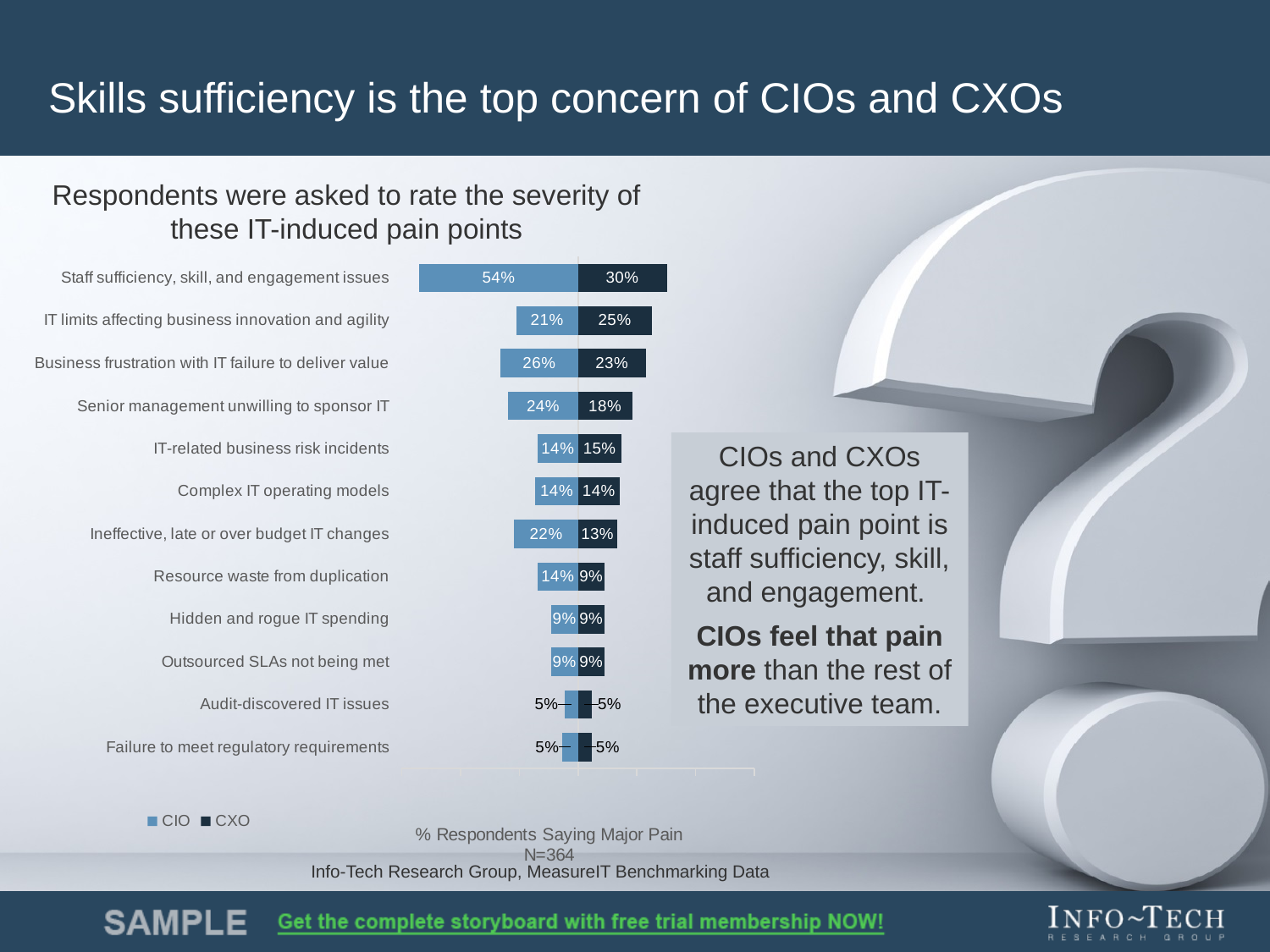
What is the CXO value for senior management unwilling to sponsor IT? 18% What percentage of CIO respondents said staff sufficiency, skill, and engagement issues were a major pain? 54% Which pain point has the highest CXO value? Staff sufficiency, skill, and engagement issues How many series does the legend list? 2 How many pain point categories are shown in the chart? 12 For business frustration with IT failure to deliver value, which is larger, the CIO value or the CXO value? CIO Which pain point has the highest CIO value? Staff sufficiency, skill, and engagement issues What kind of chart is shown on the slide? Bar chart What percentage of CXO respondents said IT limits affecting business innovation and agility were a major pain? 25% What is the CIO value for ineffective, late or over budget IT changes? 22% What is the difference between the CIO and CXO values for staff sufficiency, skill, and engagement issues? 24 percentage points What is the difference between the CIO and CXO values for ineffective, late or over budget IT changes? 9 percentage points